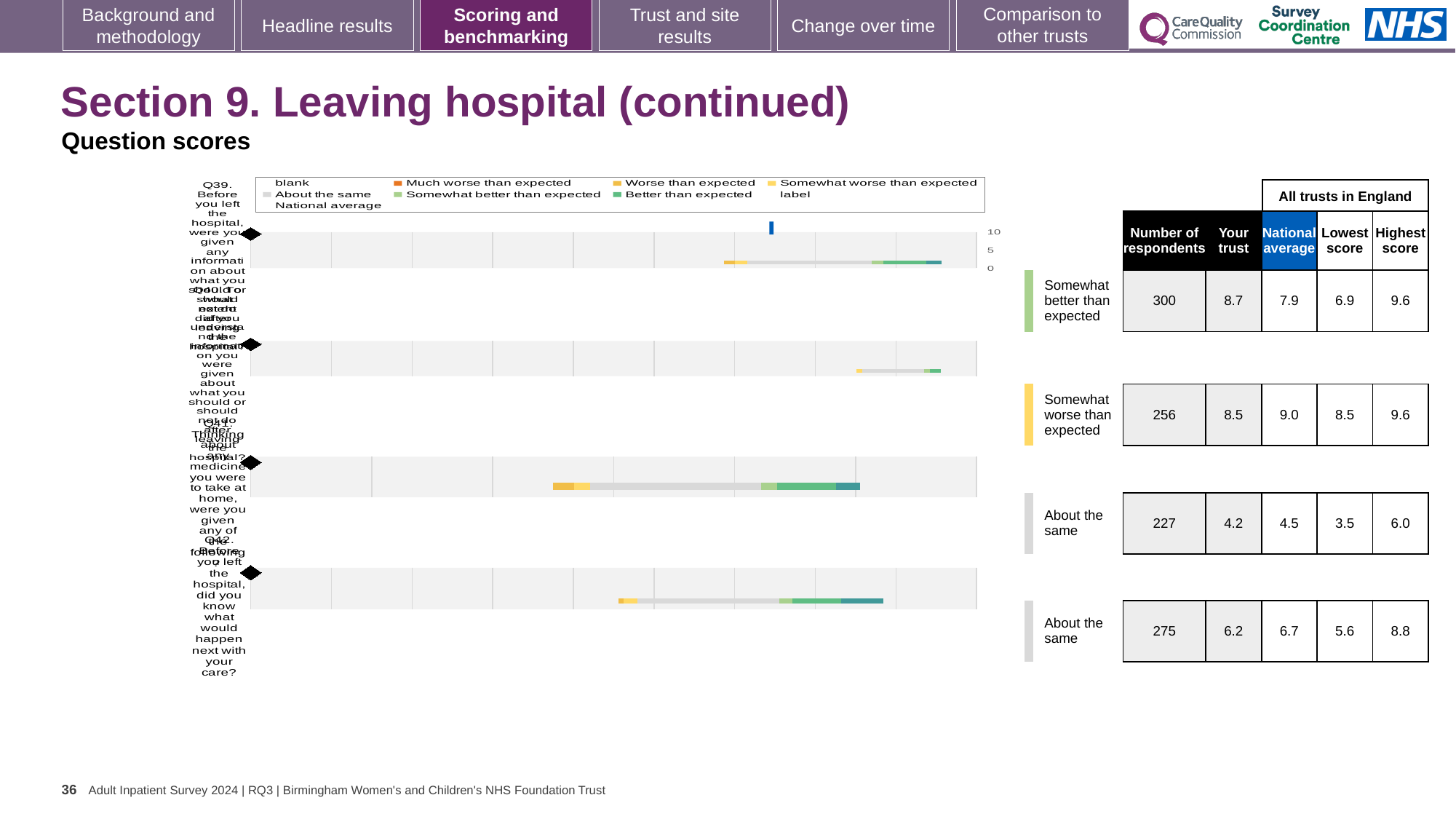
In the table beside the chart, what is the national average for Q42 (did you know what would happen next with your care)? 6.7 In the table beside the chart, what is the lowest score across all trusts in England for Q41? 3.5 In the table beside the chart, how many respondents answered Q41 (medicines to take at home)? 227 What kind of chart is shown on the slide? bar chart Is the 'Your trust' score for Q40 larger or smaller than the national average for Q40? smaller Which question row has the lowest 'Your trust' score in the table? Q41 How many question rows (Q39 to Q42) are plotted in the chart? 4 In the table beside the chart, what is the highest score across all trusts in England for Q40? 9.6 Which question row has the highest number of respondents in the table? Q39 In the table beside the chart, what is the 'Your trust' score for Q39 (information about what you should or should not do after leaving hospital)? 8.7 In the legend, which colour represents 'Much worse than expected'? orange What is the difference between the 'Your trust' score and the national average for Q39? 0.8